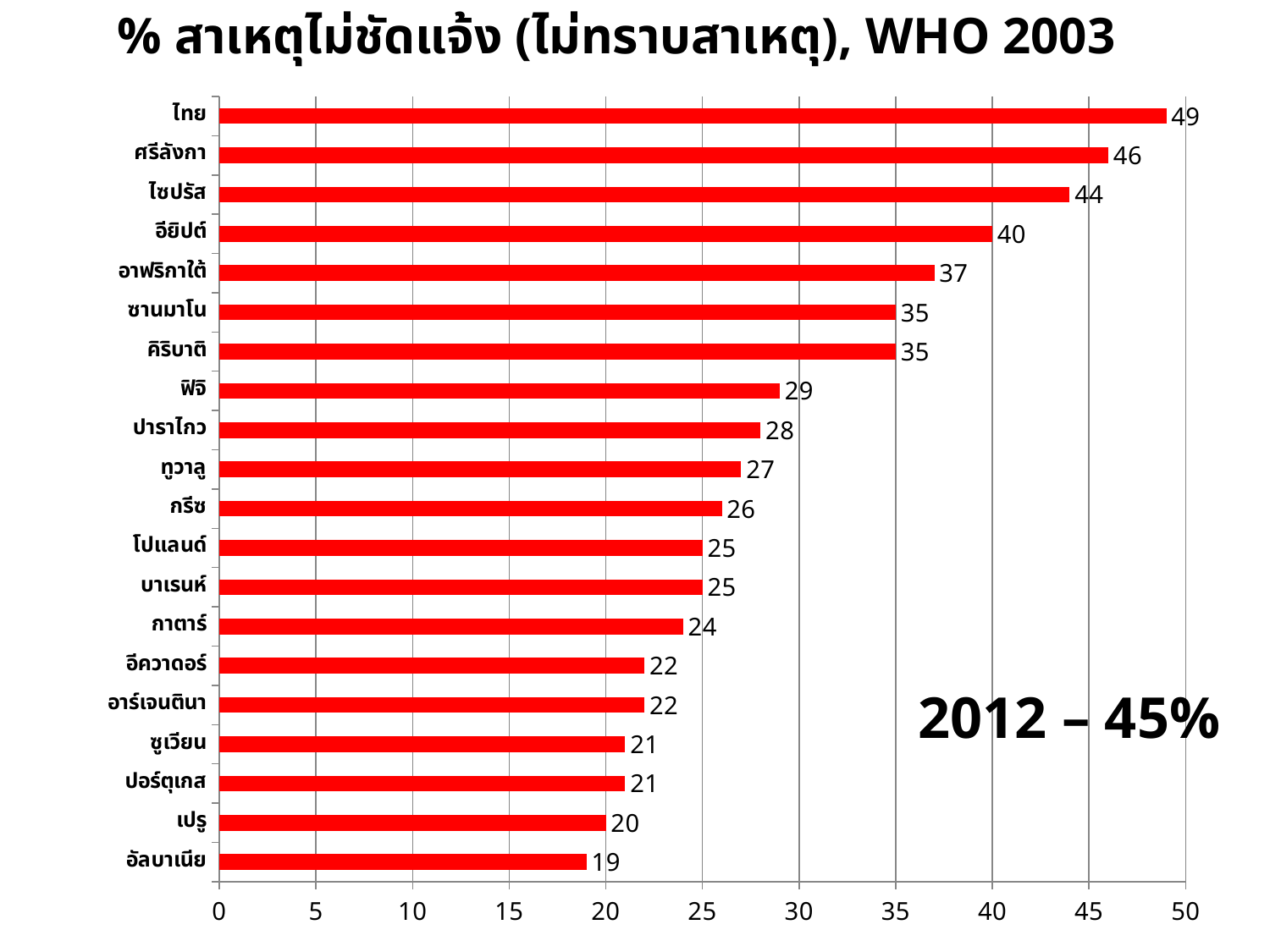
What is the difference between the values for อาฟริกาใต้ and อัลบาเนีย? 18 What is the value for อียิปต์? 40 What is the title of the chart? % สาเหตุไม่ชัดแจ้ง (ไม่ทราบสาเหตุ), WHO 2003 What kind of chart is this? bar chart How many categories are shown in the chart? 20 What is the value for ไทย? 49 Which category has the lowest value? อัลบาเนีย What is the value for ฟิจิ? 29 Which category has the highest value? ไทย Is the value for กรีซ greater or less than 30? less What is the difference between the values for ไทย and ศรีลังกา? 3